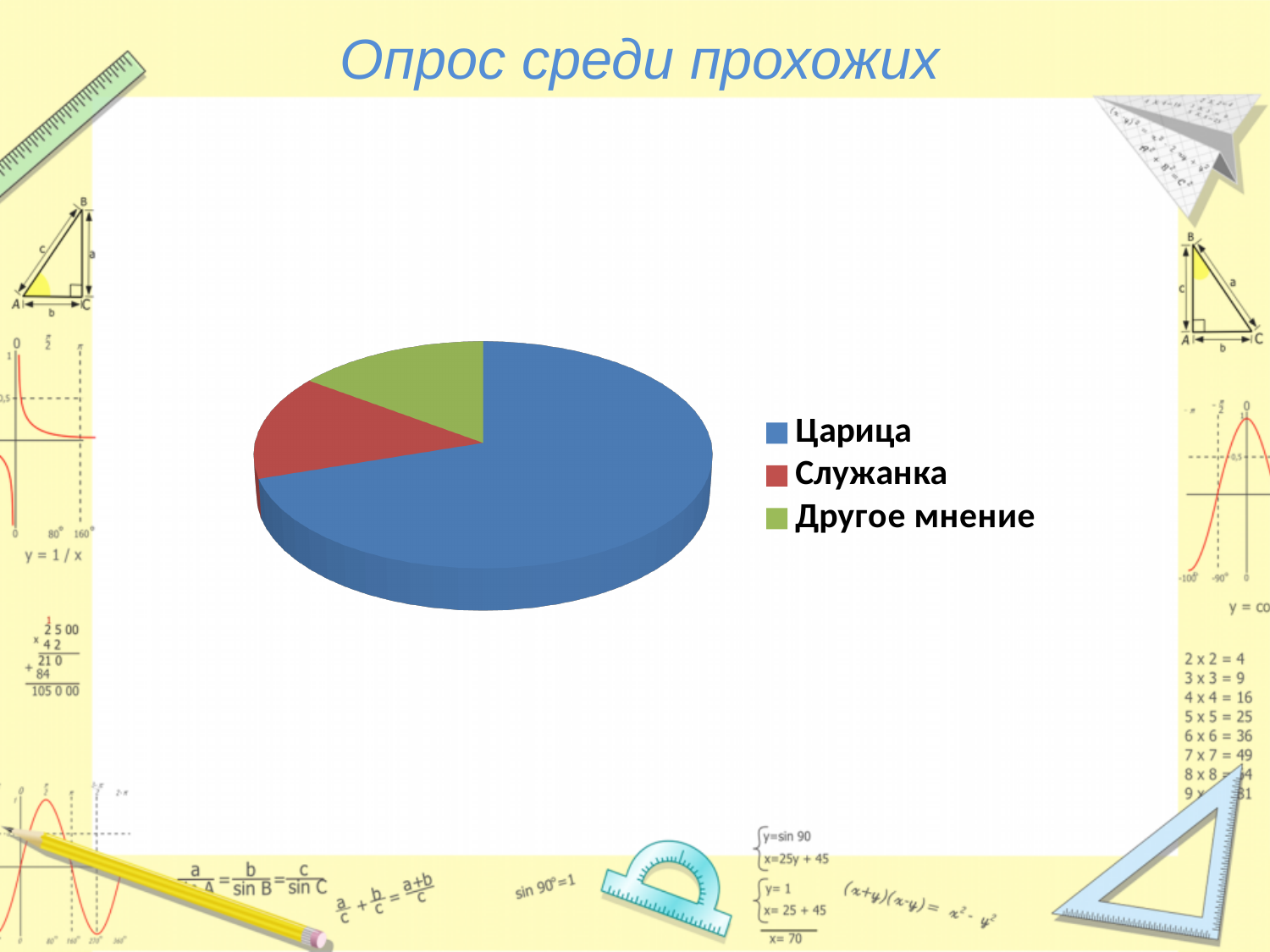
How many slices does the pie chart have? 3 Which category has the largest slice in the pie chart? Царица What kind of chart is shown on the slide? pie chart Which slice is larger, Царица or Служанка? Царица What is the title of the slide with the pie chart? Опрос среди прохожих What colour is the Царица slice in the pie chart? blue Which slice is larger, Царица or Другое мнение? Царица How many entries does the legend of the pie chart list? 3